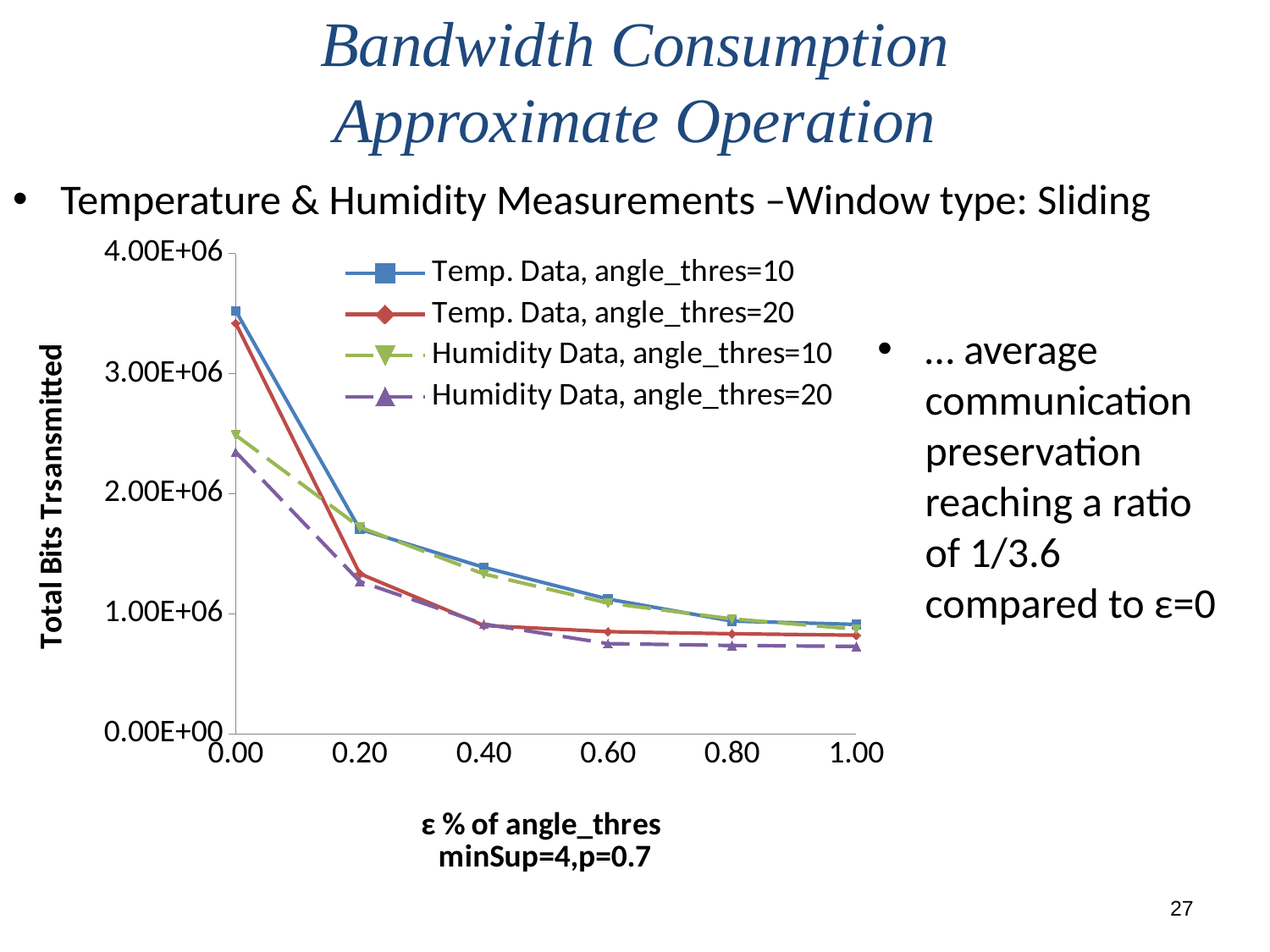
Is the value for 'Temp. Data, angle_thres=10' at ε=0.20 greater or less than 2.00E+06? less At ε=0.00, which series has the lowest value? Humidity Data, angle_thres=20 How many series does the chart legend list? 4 At ε=0.00, which is larger: 'Temp. Data, angle_thres=10' or 'Humidity Data, angle_thres=10'? Temp. Data, angle_thres=10 What kind of chart is shown on the slide? line chart Is the value for 'Temp. Data, angle_thres=10' at ε=0.00 greater or less than 3.00E+06? greater What is the title of the x axis? ε % of angle_thres minSup=4,p=0.7 As ε increases along the x axis, do the values for 'Temp. Data, angle_thres=20' rise or fall? fall How many data points are plotted for the 'Temp. Data, angle_thres=10' series? 6 What is the title of the y axis? Total Bits Trsansmitted Is the value for 'Humidity Data, angle_thres=20' at ε=1.00 greater or less than 1.00E+06? less